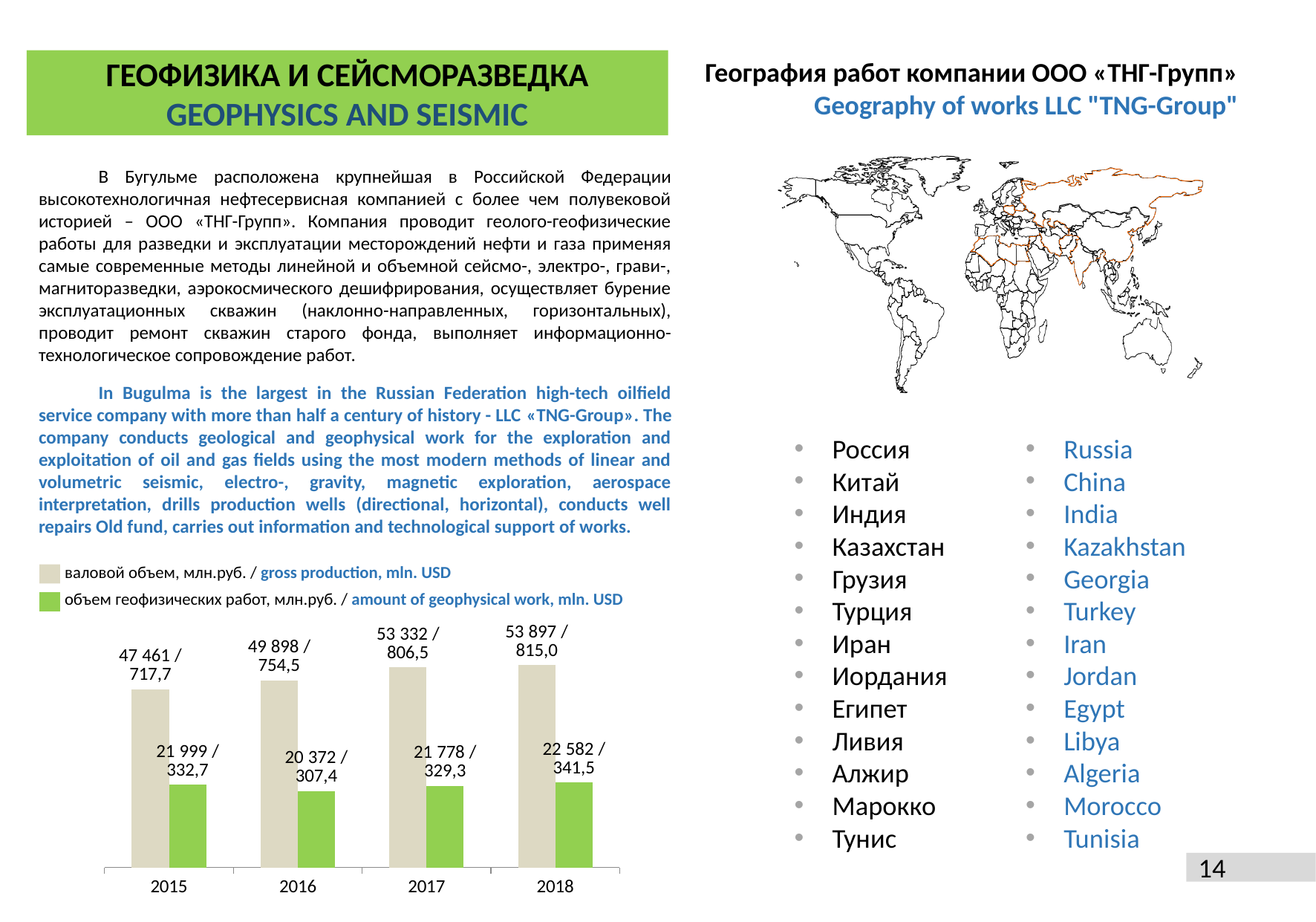
By how many mln. rub. did gross production increase from 2017 to 2018? 565 What is the data label for gross production in 2015? 47 461 / 717,7 By how many mln. rub. did the amount of geophysical work increase from 2017 to 2018? 804 Does gross production rise or fall from 2015 to 2018? rise How many years are shown on the x axis of the chart? 4 Which year has the larger amount of geophysical work, 2015 or 2016? 2015 What is the data label for the amount of geophysical work in 2018? 22 582 / 341,5 What is the data label for gross production in 2017? 53 332 / 806,5 In which year is the amount of geophysical work the lowest? 2016 What kind of chart is shown on the slide? bar chart In which year is gross production the highest? 2018 How many series does the chart legend list? 2